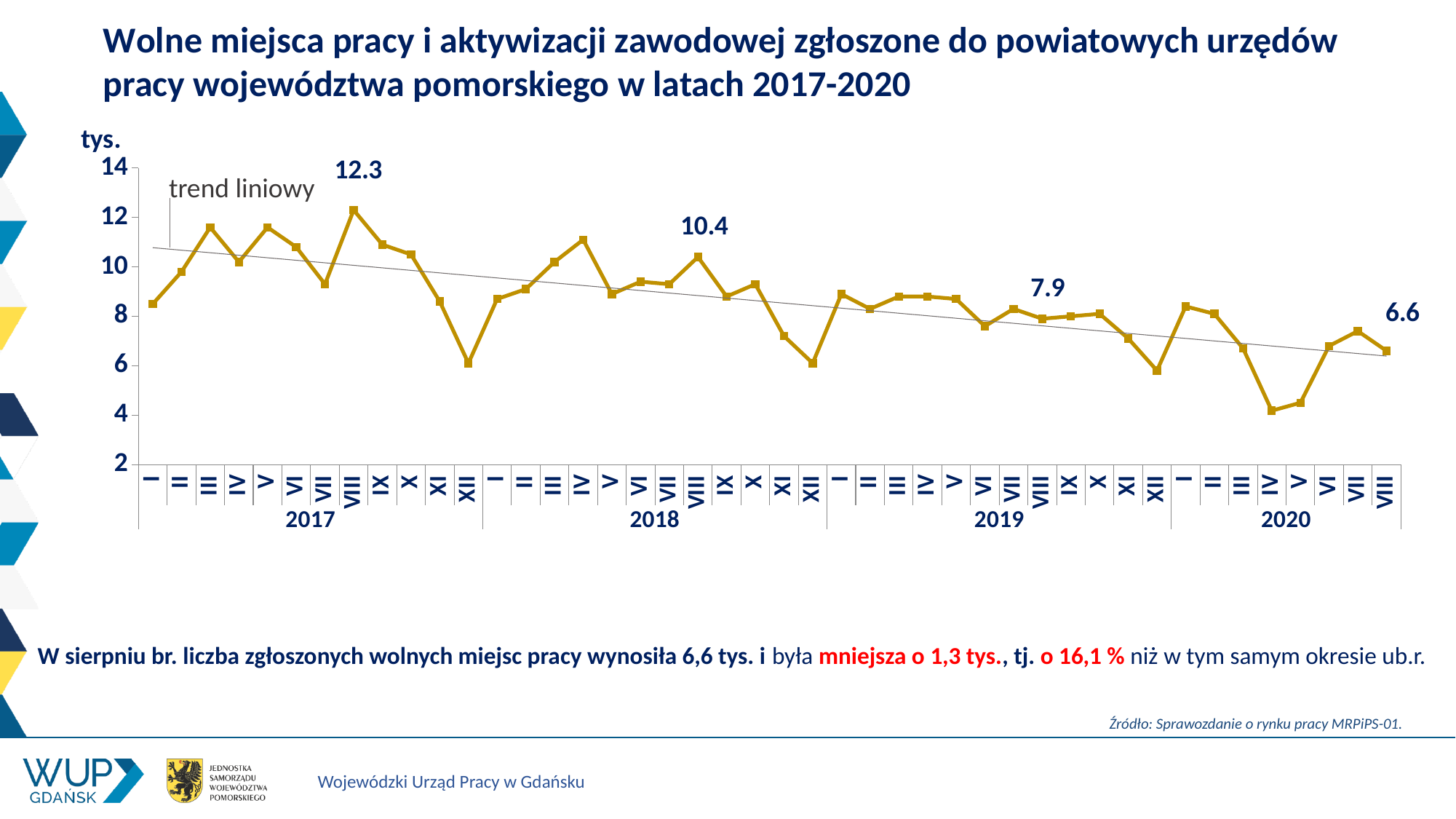
Do the values generally rise or fall from 2017 to 2020 according to the trend line? fall What is the difference between the values for VIII 2017 and VIII 2018? 1.9 What is the value for VIII 2018? 10.4 What is the value for VIII 2019? 7.9 Which month has the highest value on the chart? VIII 2017 What kind of chart is shown on the slide? line chart Which month has the lowest value on the chart? IV 2020 What is the value for VIII 2017? 12.3 What is the value for VIII 2020? 6.6 Which is larger, the value for VIII 2018 or the value for VIII 2019? VIII 2018 What is the difference between the values for VIII 2019 and VIII 2020? 1.3 Is the value for XII 2017 greater or less than 8? less